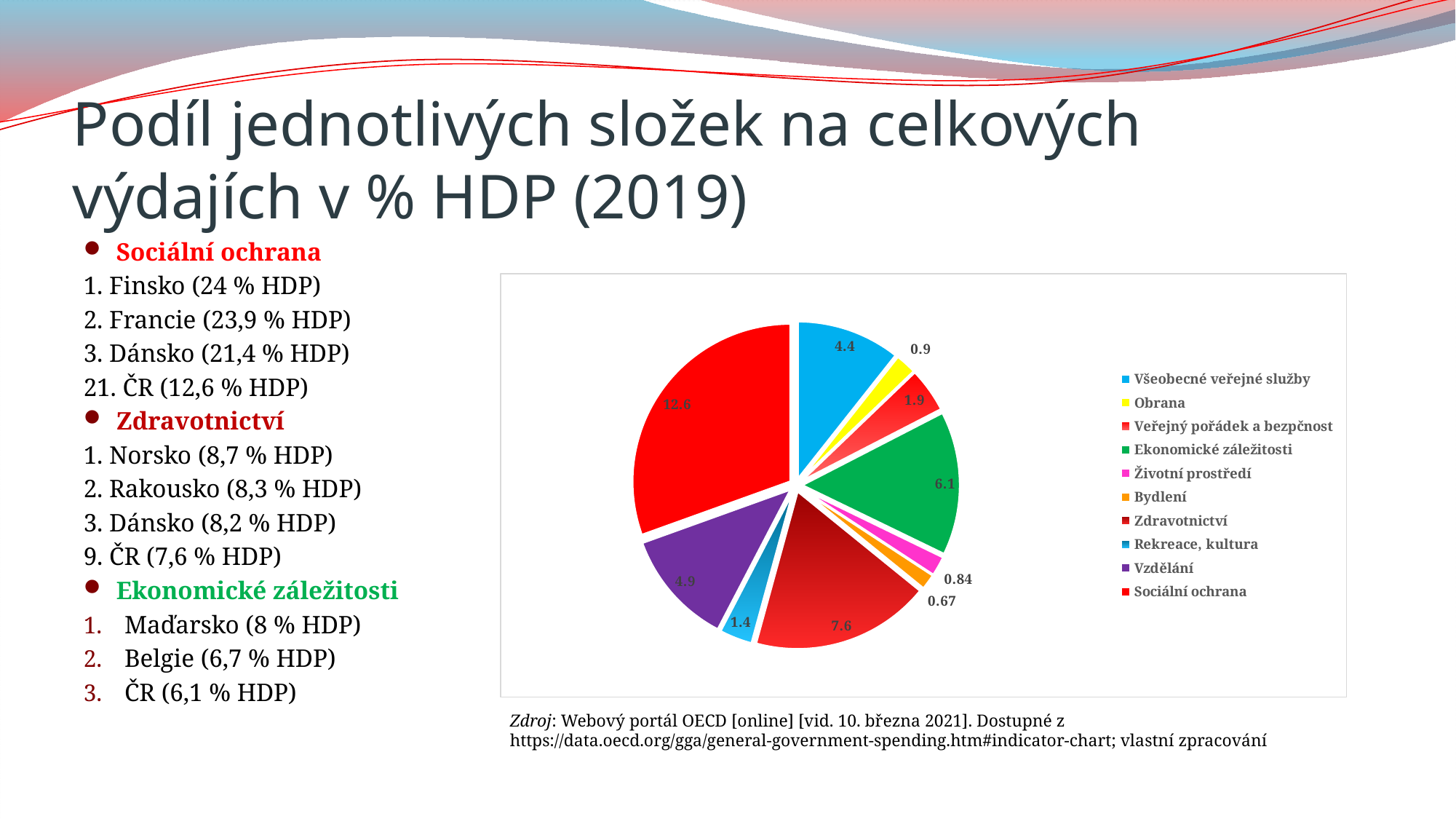
What is the value for Ekonomické záležitosti in the pie chart? 6.1 What type of chart is shown on the slide? pie chart How many categories does the pie chart have? 10 Which category has the smallest slice in the pie chart? Bydlení Which category has the largest slice in the pie chart? Sociální ochrana What is the value for Bydlení in the pie chart? 0.67 What is the difference between the values for Sociální ochrana and Zdravotnictví? 5.0 What colour is the Ekonomické záležitosti slice in the pie chart? green What is the value for Zdravotnictví in the pie chart? 7.6 What is the value for Obrana in the pie chart? 0.9 What is the value for Sociální ochrana in the pie chart? 12.6 Which is larger in the pie chart, Vzdělání or Všeobecné veřejné služby? Vzdělání